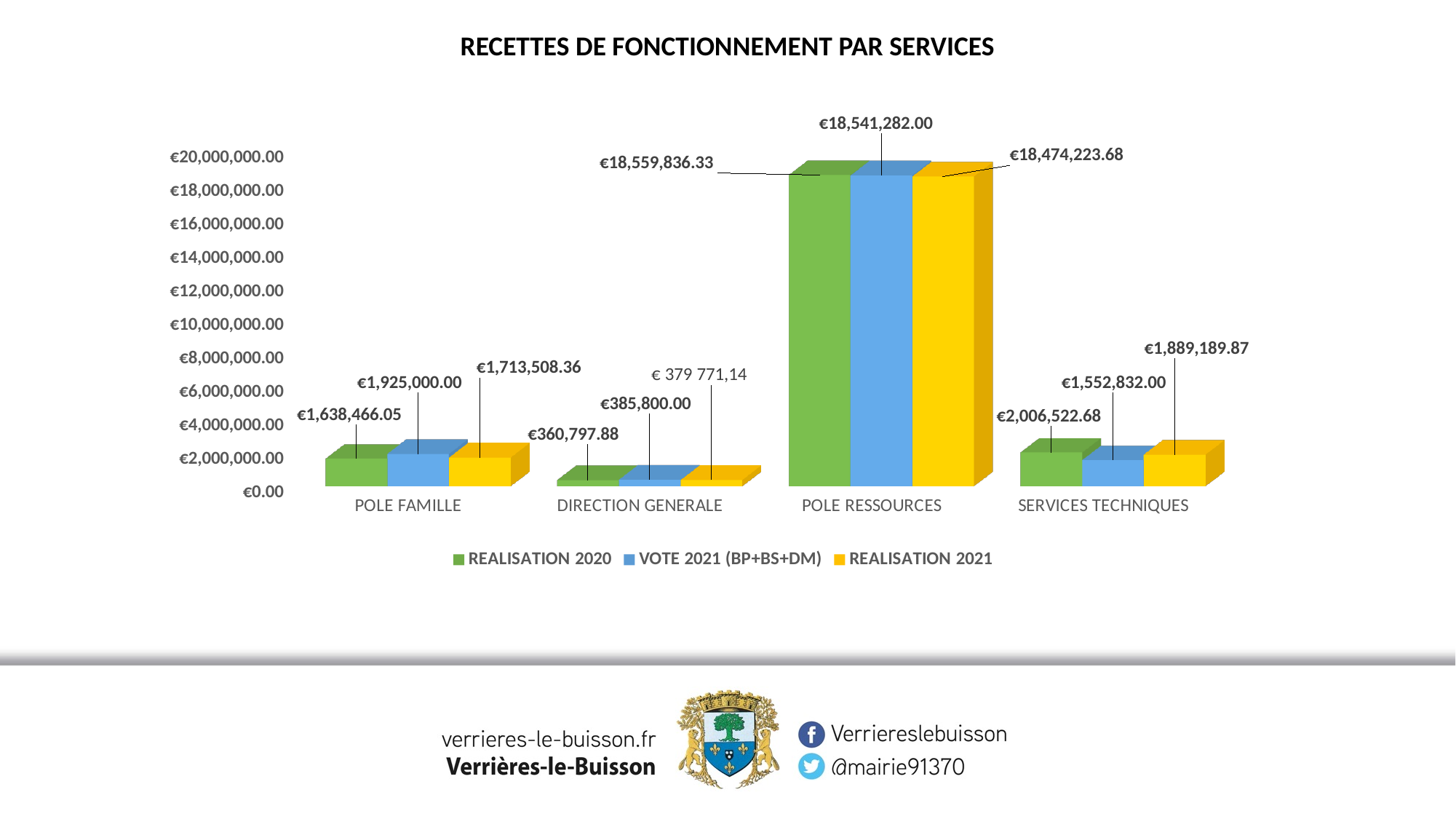
What is the VOTE 2021 (BP+BS+DM) value for POLE RESSOURCES? €18,541,282.00 What is the REALISATION 2020 value for DIRECTION GENERALE? €360,797.88 What is the difference between the VOTE 2021 (BP+BS+DM) and REALISATION 2021 values for POLE FAMILLE? €211,491.64 Which category has the lowest VOTE 2021 (BP+BS+DM) value? DIRECTION GENERALE How many series does the legend list? 3 What is the REALISATION 2020 value for POLE FAMILLE? €1,638,466.05 How many service categories are shown on the x axis? 4 What type of chart is shown on the slide? Bar chart For SERVICES TECHNIQUES, which is larger: REALISATION 2020 or VOTE 2021 (BP+BS+DM)? REALISATION 2020 Which category has the highest REALISATION 2021 value? POLE RESSOURCES What is the REALISATION 2021 value for SERVICES TECHNIQUES? €1,889,189.87 What is the title of the chart? RECETTES DE FONCTIONNEMENT PAR SERVICES